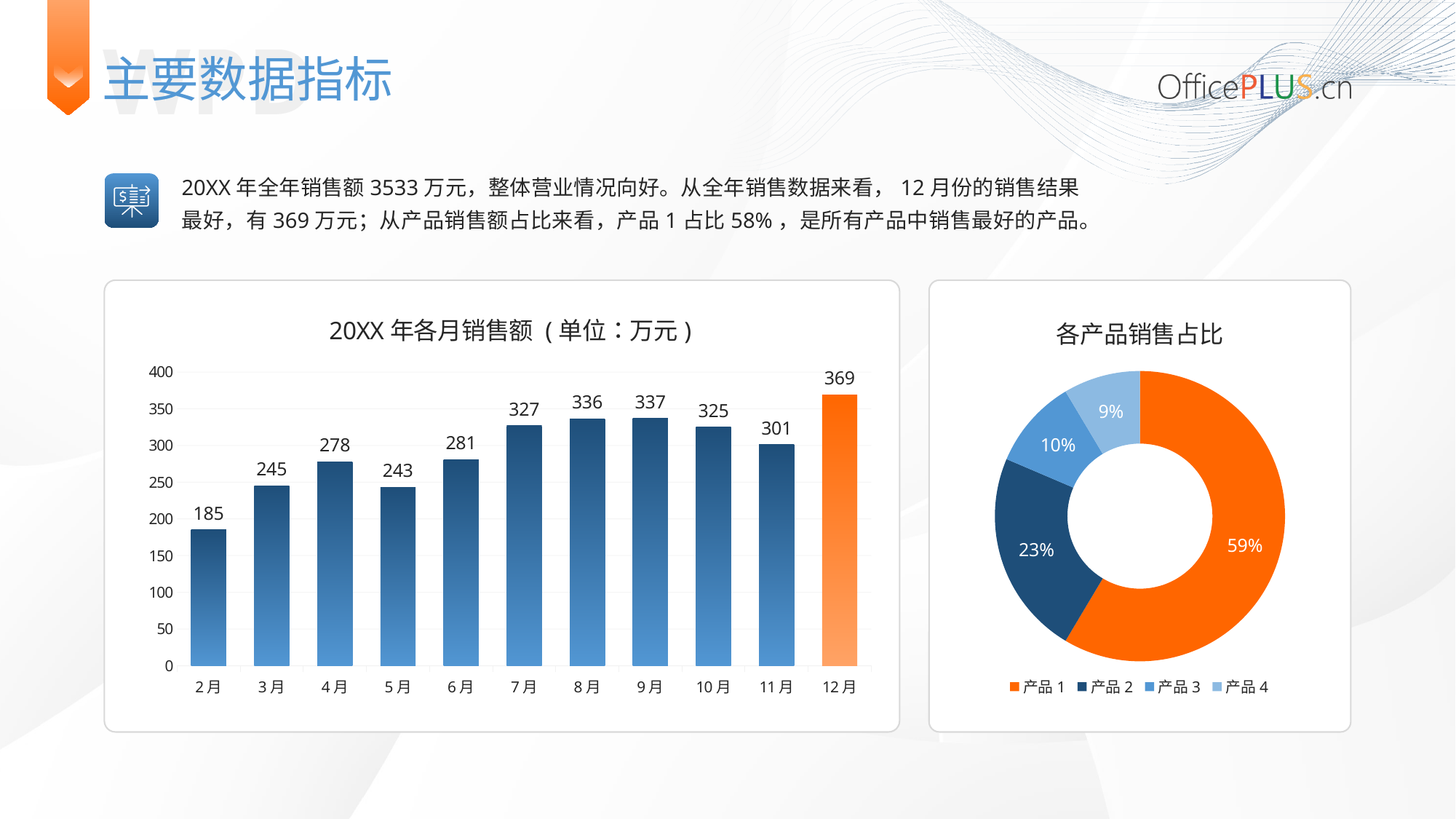
In the chart titled 20XX 年各月销售额（单位：万元）, how many months are plotted? 11 In the chart titled 各产品销售占比, what share does 产品 1 have? 59% In the chart titled 各产品销售占比, how many products does the legend list? 4 In the chart titled 20XX 年各月销售额（单位：万元）, what is the value for 7 月? 327 In the chart titled 各产品销售占比, which product has the smallest share? 产品 4 In the chart titled 20XX 年各月销售额（单位：万元）, which month has the lowest value? 2 月 What kind of chart is the one titled 20XX 年各月销售额（单位：万元）? Bar chart In the chart titled 20XX 年各月销售额（单位：万元）, what is the value for 2 月? 185 In the chart titled 20XX 年各月销售额（单位：万元）, which is larger, the value for 4 月 or the value for 5 月? 4 月 In the chart titled 20XX 年各月销售额（单位：万元）, what is the difference between the values for 12 月 and 11 月? 68 In the chart titled 各产品销售占比, what is the value for 产品 3? 10% In the chart titled 20XX 年各月销售额（单位：万元）, which month has the highest value? 12 月